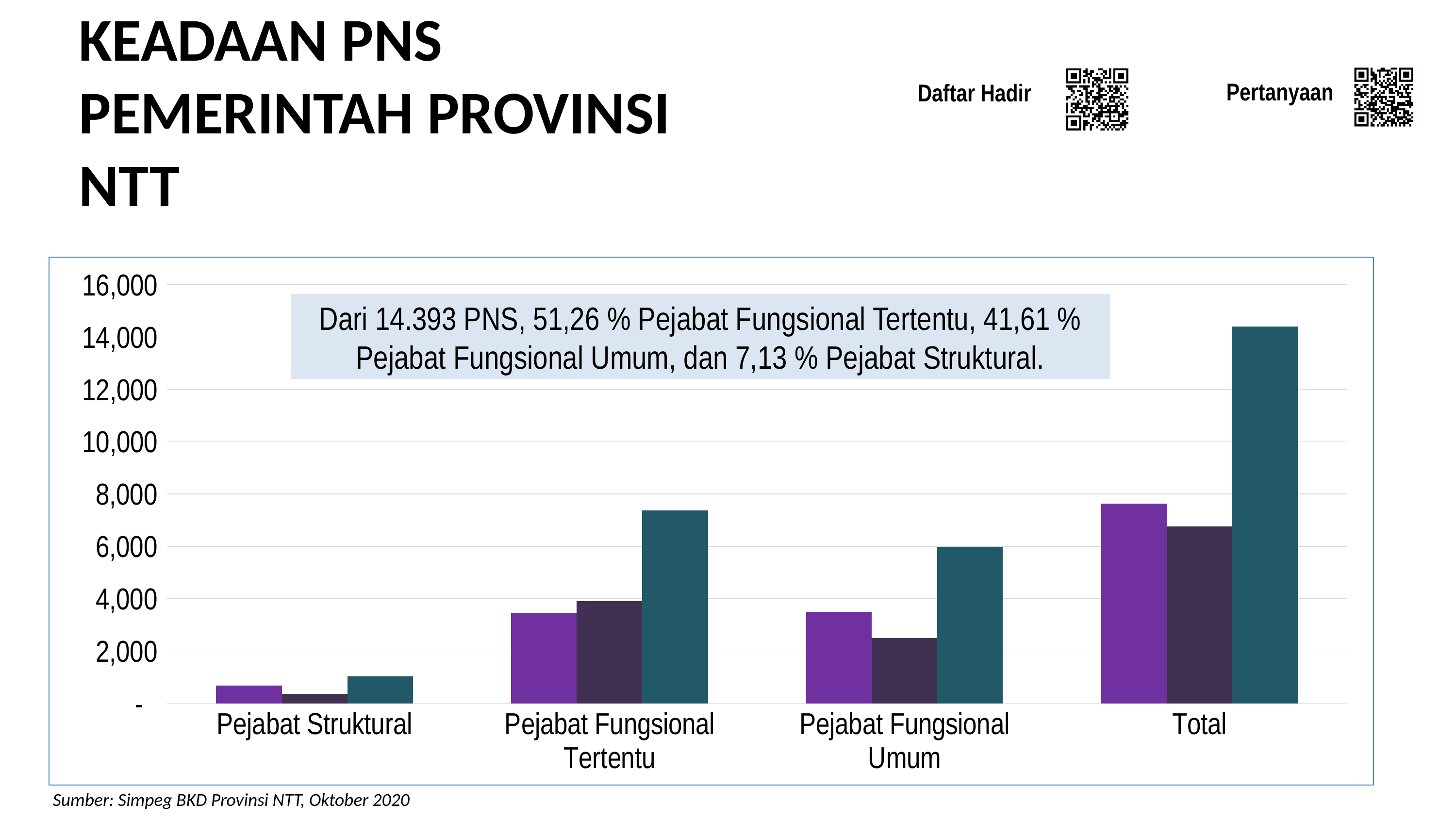
Which category has the shortest bars in the chart? Pejabat Struktural Is the teal bar for Pejabat Struktural greater or less than 2,000? less What kind of chart is shown on the slide? bar chart Is the teal bar for Pejabat Fungsional Umum greater or less than 4,000? greater Is the teal bar for Pejabat Fungsional Tertentu greater or less than 8,000? less Which category has the tallest bar in the chart? Total Excluding Total, which category has the tallest teal bar? Pejabat Fungsional Tertentu Which is larger: the teal bar for Pejabat Fungsional Tertentu or the teal bar for Pejabat Fungsional Umum? Pejabat Fungsional Tertentu According to the text box on the chart, what percentage of PNS are Pejabat Struktural? 7,13 % How many bars are plotted for each category in the chart? 3 How many categories are shown on the x axis of the chart? 4